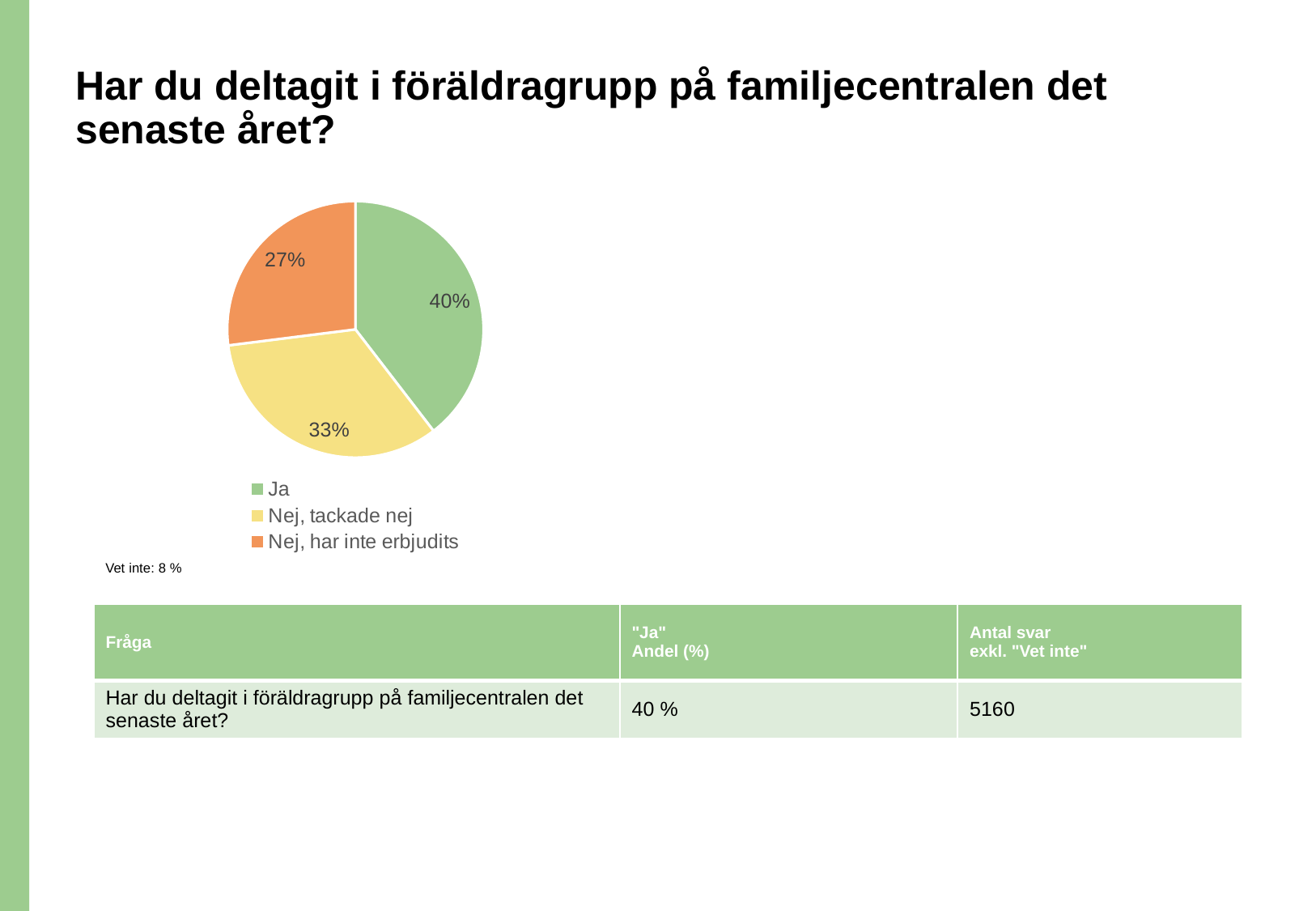
How many slices does the pie chart have? 3 What share of the pie does "Nej, har inte erbjudits" represent? 27% Which category has the largest slice of the pie? Ja Which category has the smallest slice of the pie? Nej, har inte erbjudits What kind of chart is shown on the slide? pie chart What share of the pie does "Ja" represent? 40% Which colour represents "Nej, har inte erbjudits" in the pie chart? orange What is the difference in percentage points between the "Ja" slice and the "Nej, har inte erbjudits" slice? 13 How many entries does the legend list? 3 What share of the pie does "Nej, tackade nej" represent? 33% What is the difference in percentage points between the "Nej, tackade nej" slice and the "Nej, har inte erbjudits" slice? 6 Which is larger, the "Ja" slice or the "Nej, tackade nej" slice? Ja